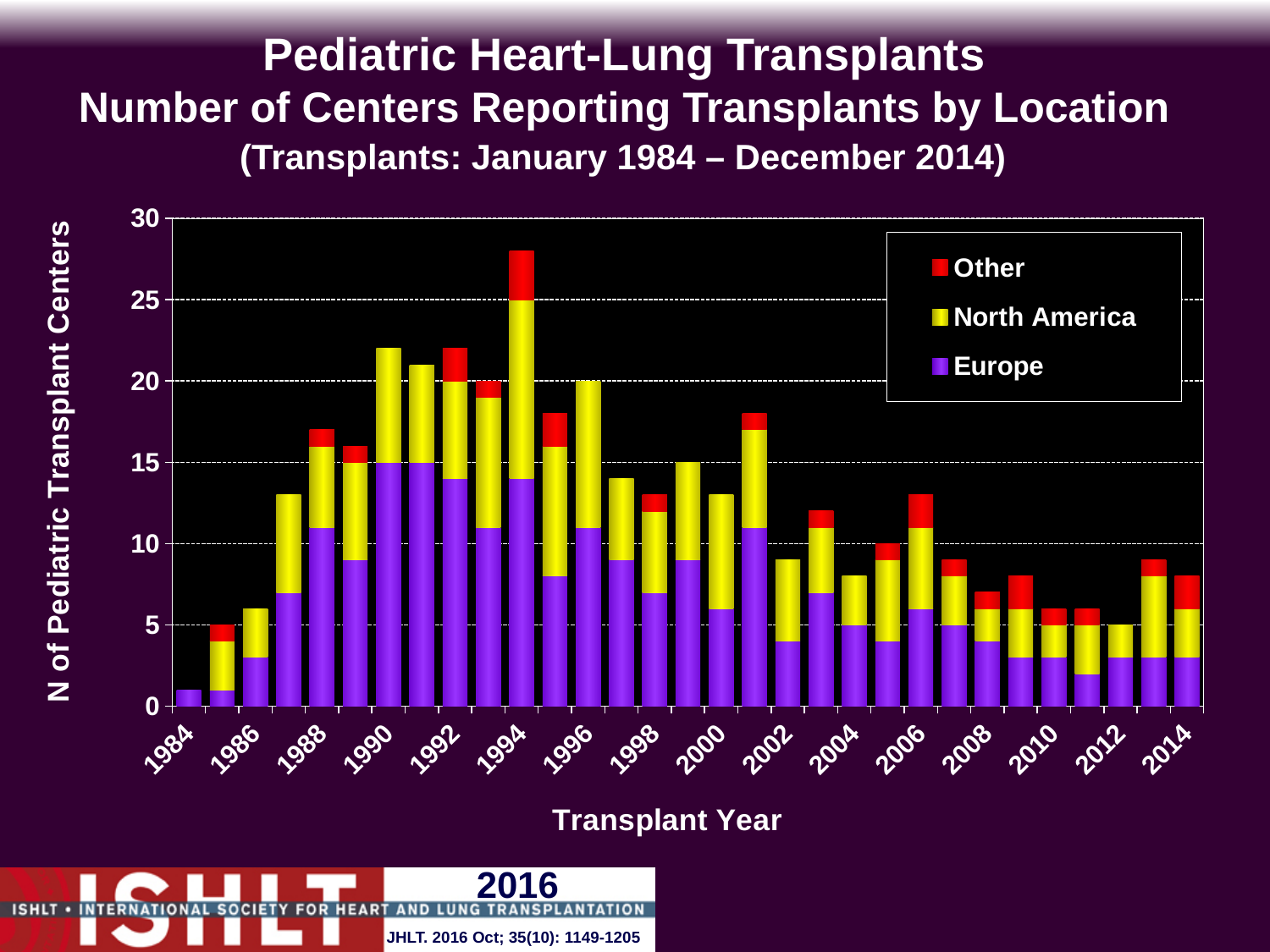
What colour represents Europe in the legend? Purple Which year has a larger total number of centers, 1990 or 2000? 1990 Is the total number of centers for 1984 greater or less than 5? less How many series does the legend list? 3 Do the total numbers of centers generally rise or fall from 1994 to 2002? fall How many transplant years are plotted along the x axis? 31 Which transplant year has the highest total number of pediatric transplant centers? 1994 Which transplant year has the lowest total number of pediatric transplant centers? 1984 Is the total number of centers for 1990 greater or less than 20? greater What kind of chart is shown on the slide? Stacked bar chart Is the total number of centers for 2000 greater or less than 15? less